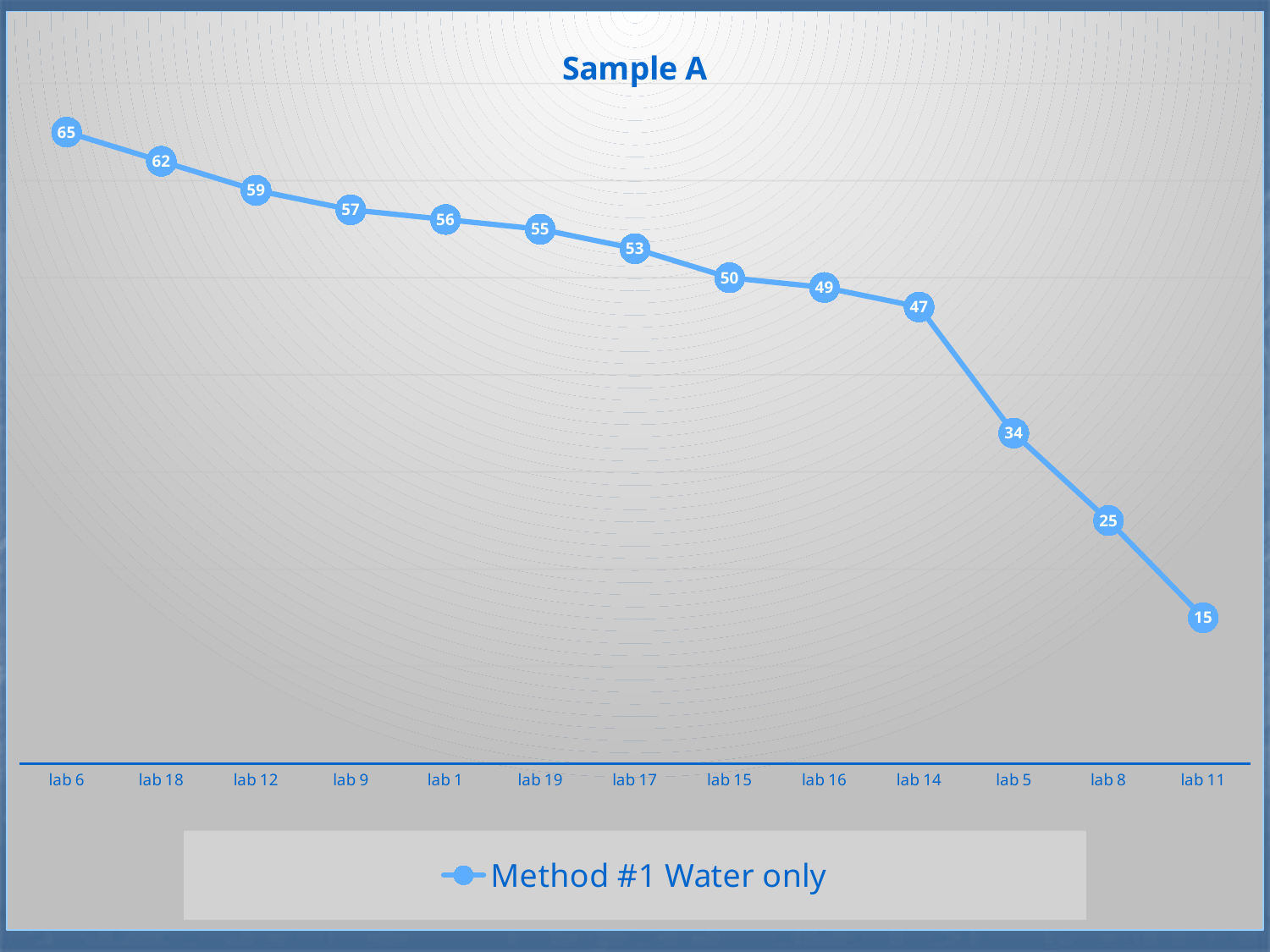
Which has a larger value, lab 12 or lab 16? lab 12 What is the value for lab 8? 25 How many series does the legend list? 1 What is the value for lab 6? 65 What kind of chart is shown? line chart Do the values rise or fall from left to right along the x axis? fall Which lab has the lowest value? lab 11 How many labs are plotted on the x axis? 13 What is the value for lab 17? 53 What is the title of the chart? Sample A Which lab has the highest value? lab 6 What is the difference between the values for lab 14 and lab 5? 13